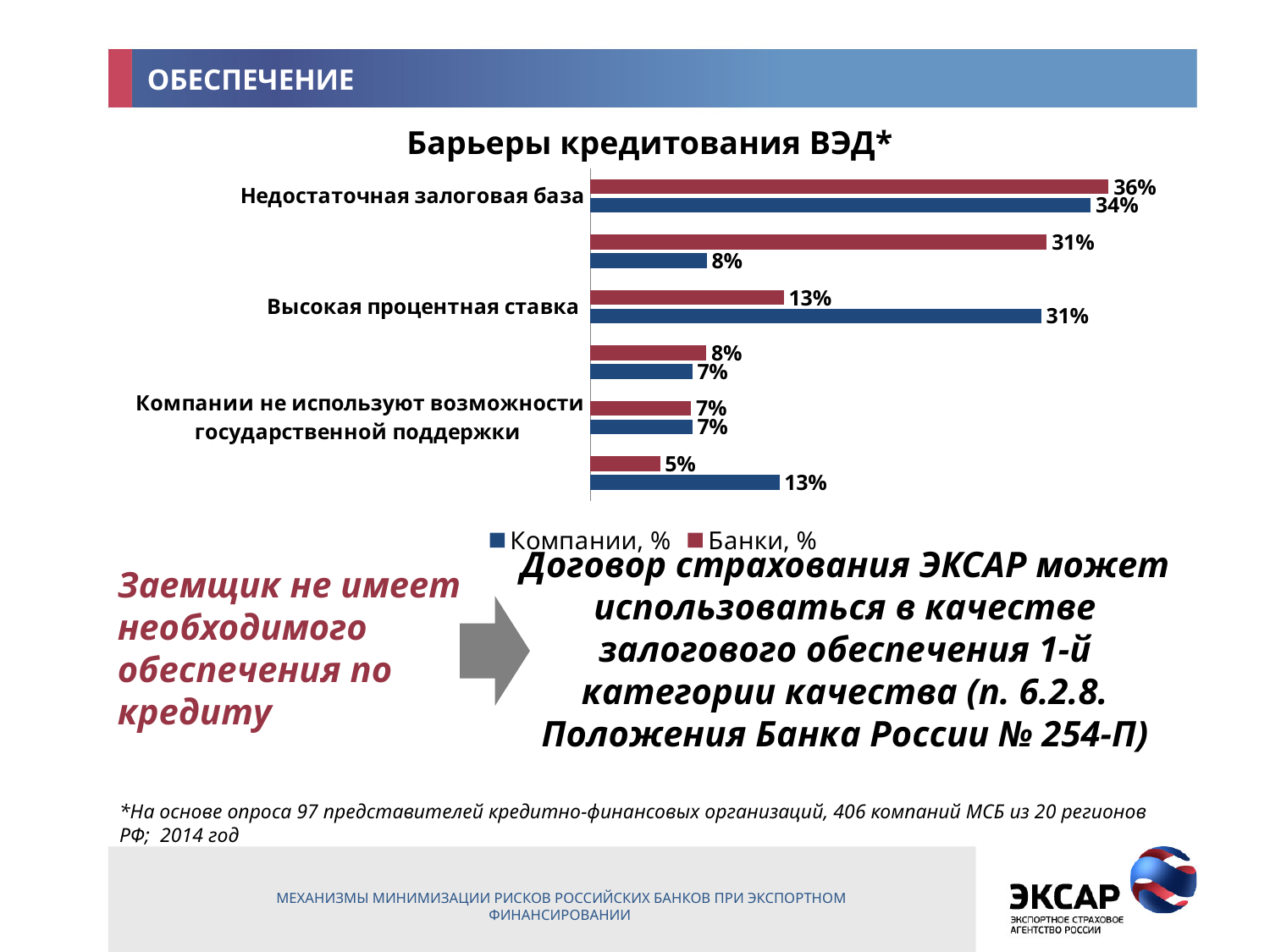
How many series does the legend of the chart 'Барьеры кредитования ВЭД*' list? 2 What kind of chart is 'Барьеры кредитования ВЭД*'? Bar chart In the chart 'Барьеры кредитования ВЭД*', what is the value for Компании, % for 'Компании не используют возможности государственной поддержки'? 7% In the chart 'Барьеры кредитования ВЭД*', for 'Недостаточная залоговая база', which series has the larger value, Компании, % or Банки, %? Банки, % In the chart 'Барьеры кредитования ВЭД*', which labelled category has the highest Банки, % value? Недостаточная залоговая база What are the legend entries of the chart 'Барьеры кредитования ВЭД*'? Компании, % and Банки, % In the chart 'Барьеры кредитования ВЭД*', what is the difference between the Банки, % and Компании, % values for 'Недостаточная залоговая база'? 2% In the chart 'Барьеры кредитования ВЭД*', what is the value for Банки, % for 'Недостаточная залоговая база'? 36% In the chart 'Барьеры кредитования ВЭД*', what is the value for Компании, % for 'Высокая процентная ставка'? 31% In the chart 'Барьеры кредитования ВЭД*', what is the value for Компании, % for 'Недостаточная залоговая база'? 34% In the chart 'Барьеры кредитования ВЭД*', what is the difference between the Компании, % and Банки, % values for 'Высокая процентная ставка'? 18% In the chart 'Барьеры кредитования ВЭД*', what is the value for Банки, % for 'Высокая процентная ставка'? 13%